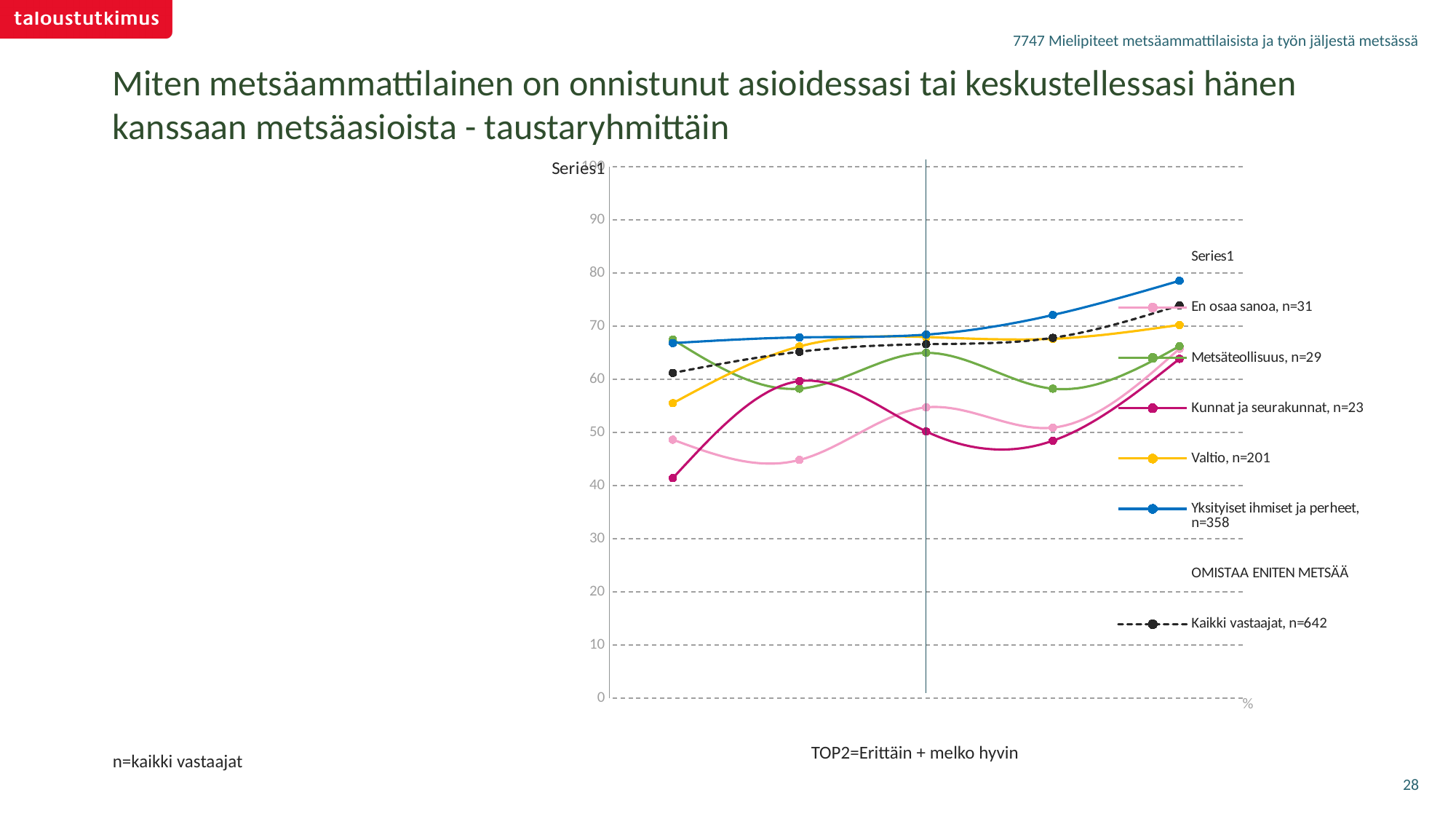
Does the line for Yksityiset ihmiset ja perheet, n=358 generally rise or fall from left to right? rise Is the first (leftmost) value for Kunnat ja seurakunnat, n=23 greater or less than 50? less Is the last (rightmost) value for Yksityiset ihmiset ja perheet, n=358 greater or less than 70? greater Which series is drawn with a dashed black line? Kaikki vastaajat, n=642 Is the first (leftmost) value for Yksityiset ihmiset ja perheet, n=358 greater or less than 60? greater At the rightmost point, which is larger: Yksityiset ihmiset ja perheet, n=358 or Kunnat ja seurakunnat, n=23? Yksityiset ihmiset ja perheet, n=358 How many series with line markers does the legend list? 6 Which series has the lowest value at the leftmost point? Kunnat ja seurakunnat, n=23 How many data points does each line have along the x axis? 5 Which series has the highest value at the rightmost point? Yksityiset ihmiset ja perheet, n=358 What kind of chart is shown on the slide? line chart